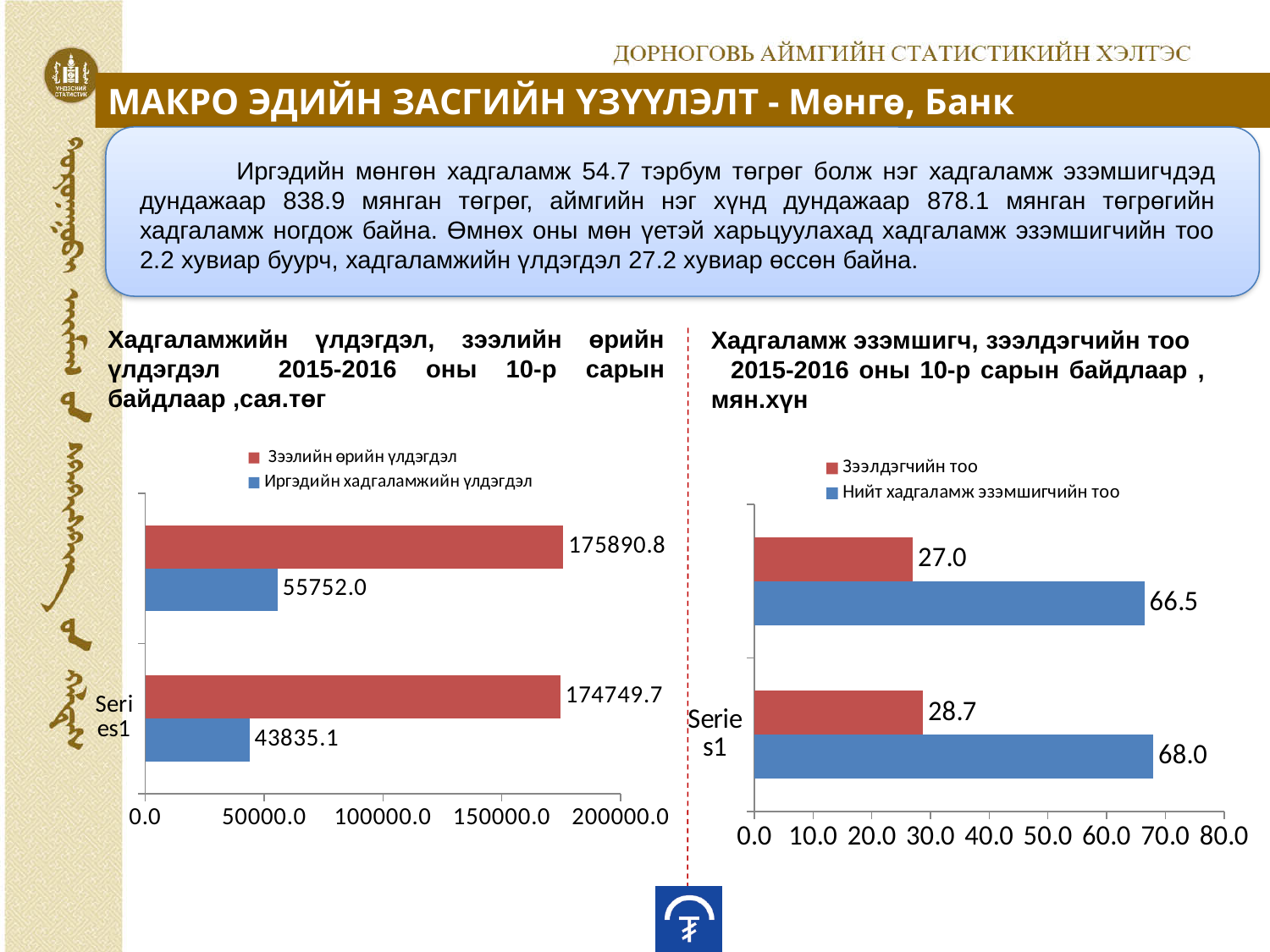
In the right chart (Хадгаламж эзэмшигч, зээлдэгчийн тоо), which bar is the highest? Нийт хадгаламж эзэмшигчийн тоо in the lower group (Series1), 68.0 What kind of chart is the left chart, titled 'Хадгаламжийн үлдэгдэл, зээлийн өрийн үлдэгдэл'? bar chart In the right chart (Хадгаламж эзэмшигч, зээлдэгчийн тоо), what is the difference between the two Зээлдэгчийн тоо bars (28.7 and 27.0)? 1.7 In the left chart (Хадгаламжийн үлдэгдэл, зээлийн өрийн үлдэгдэл), what is the difference between the two Иргэдийн хадгаламжийн үлдэгдэл bars (55752.0 and 43835.1)? 11916.9 In the right chart (Хадгаламж эзэмшигч, зээлдэгчийн тоо), what is the value of the Зээлдэгчийн тоо bar in the upper group of bars? 27.0 In the right chart (Хадгаламж эзэмшигч, зээлдэгчийн тоо), what is the value of the Нийт хадгаламж эзэмшигчийн тоо bar in the lower group labelled Series1? 68.0 In the left chart (Хадгаламжийн үлдэгдэл, зээлийн өрийн үлдэгдэл), which colour represents Зээлийн өрийн үлдэгдэл? red In the left chart (Хадгаламжийн үлдэгдэл, зээлийн өрийн үлдэгдэл), what is the value of the Зээлийн өрийн үлдэгдэл bar in the upper group of bars? 175890.8 In the left chart (Хадгаламжийн үлдэгдэл, зээлийн өрийн үлдэгдэл), what is the value of the Иргэдийн хадгаламжийн үлдэгдэл bar in the lower group labelled Series1? 43835.1 In the right chart (Хадгаламж эзэмшигч, зээлдэгчийн тоо), what unit is stated in the chart title? мян.хүн In the left chart (Хадгаламжийн үлдэгдэл, зээлийн өрийн үлдэгдэл), which series has the larger values, Зээлийн өрийн үлдэгдэл or Иргэдийн хадгаламжийн үлдэгдэл? Зээлийн өрийн үлдэгдэл In the left chart (Хадгаламжийн үлдэгдэл, зээлийн өрийн үлдэгдэл), how many series does the legend list? 2